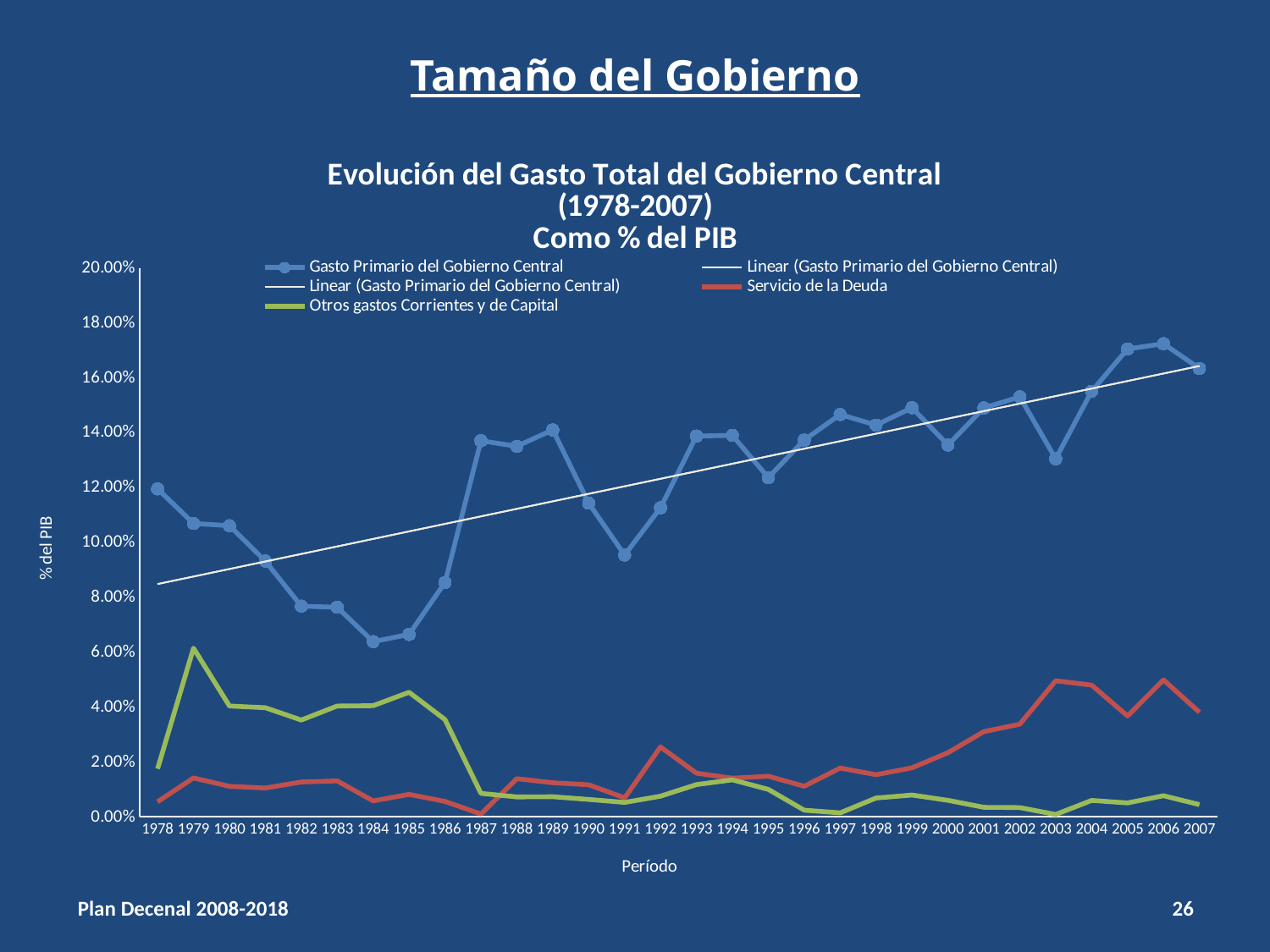
Is the value of Gasto Primario del Gobierno Central in 2005 greater or less than 16.00%? greater How many years are plotted along the x axis of the chart? 30 Is the value of Otros gastos Corrientes y de Capital in 1979 greater or less than 4.00%? greater Is the value of Gasto Primario del Gobierno Central in 1984 greater or less than 8.00%? less Which is larger for Gasto Primario del Gobierno Central: the value in 1987 or the value in 1991? 1987 Does Gasto Primario del Gobierno Central generally rise or fall from 1978 to 2007? rise What kind of chart is shown on the slide? line chart How many series does the chart legend list? 5 In which year does Otros gastos Corrientes y de Capital reach its highest value? 1979 In 2003, which series has the larger value: Servicio de la Deuda or Otros gastos Corrientes y de Capital? Servicio de la Deuda What is the label on the y axis of the chart? % del PIB